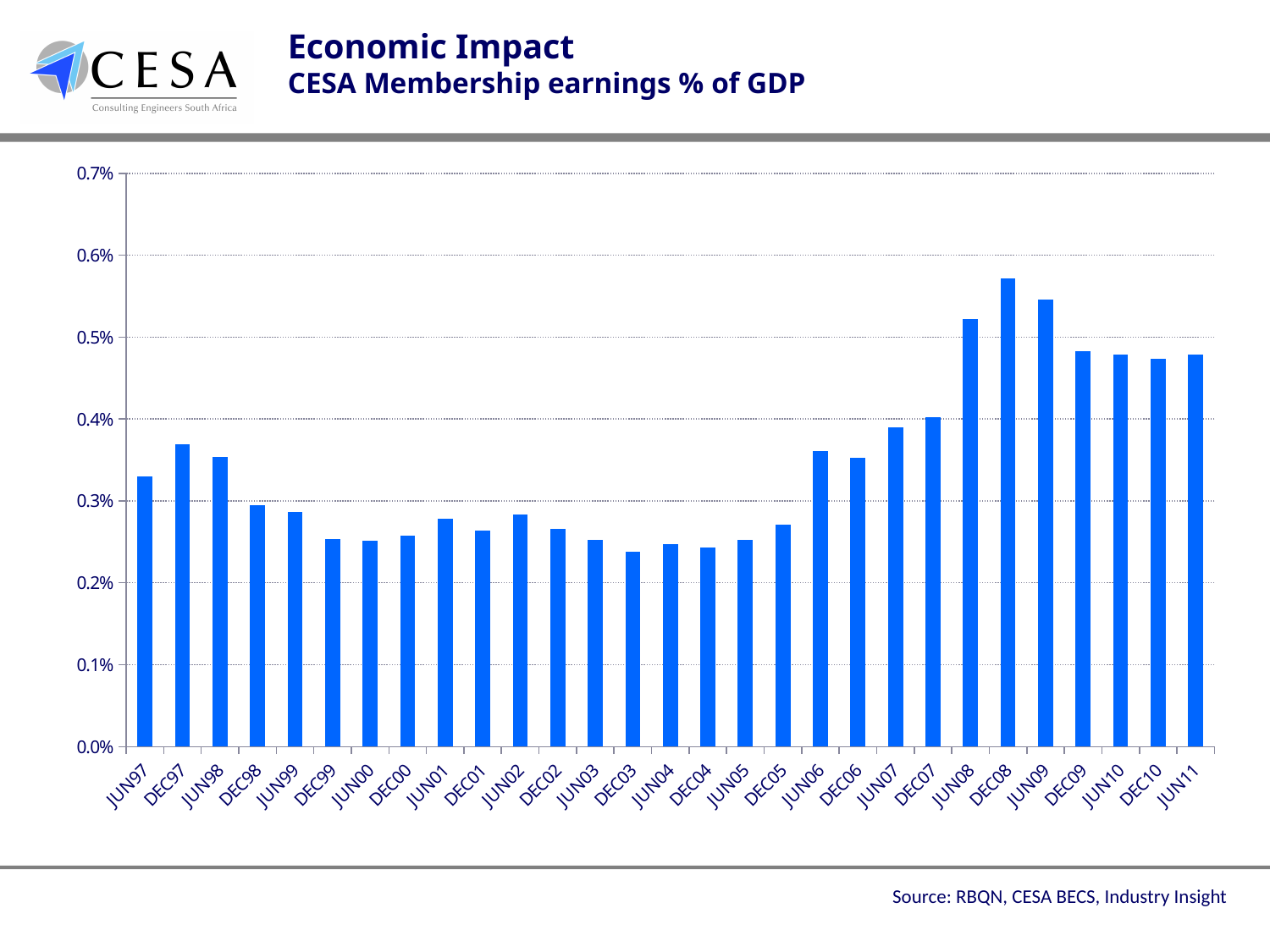
Which is larger, the value for JUN05 or the value for JUN06? JUN06 Which period has the highest CESA membership earnings as a % of GDP? DEC08 Which is larger, the value for JUN97 or the value for DEC97? DEC97 Is the value for JUN00 greater or less than 0.3%? less Is the value for JUN97 greater or less than 0.3%? greater Do the values generally rise or fall from JUN06 to DEC08? rise Is the value for DEC03 greater or less than 0.3%? less What is the subtitle describing the chart on the slide? CESA Membership earnings % of GDP What kind of chart is shown on the slide? bar chart How many bars (time periods) are plotted on the chart? 29